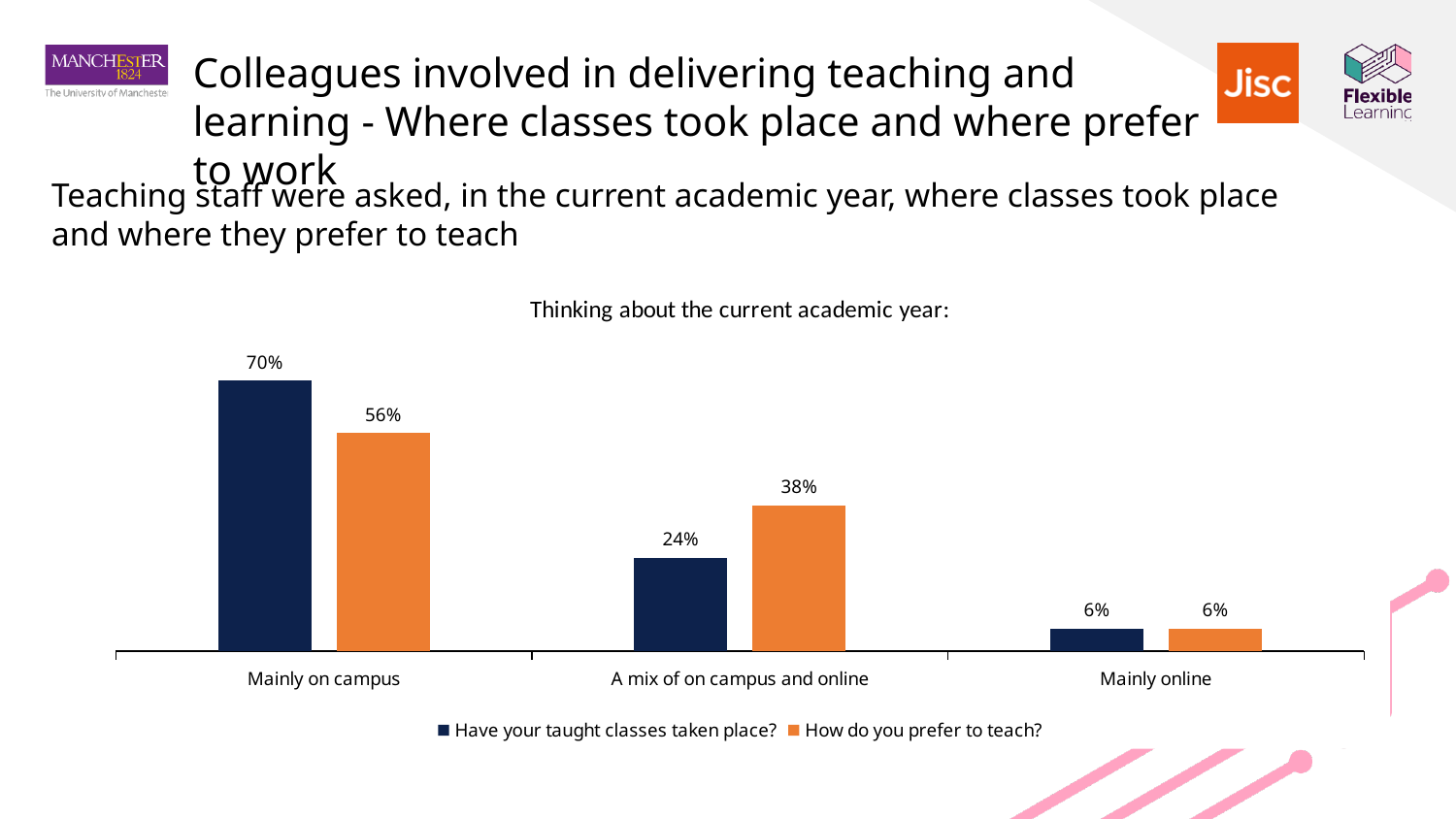
What percentage of teaching staff prefer to teach with a mix of on campus and online? 38% Which category has the highest value for 'Have your taught classes taken place?' Mainly on campus How many categories are shown on the x axis of the chart? 3 Which category has the lowest value for 'How do you prefer to teach?' Mainly online What type of chart is shown on the slide? Bar chart What percentage of teaching staff said their taught classes took place mainly on campus? 70% For 'A mix of on campus and online', which is larger: where classes took place or where staff prefer to teach? How do you prefer to teach? What is the title of the chart? Thinking about the current academic year: What percentage of teaching staff said their taught classes took place mainly online? 6% Do the values for 'Have your taught classes taken place?' rise or fall from left to right across the categories? Fall How many series does the chart legend list? 2 What is the difference between where classes took place and preferred teaching location for 'Mainly on campus'? 14%